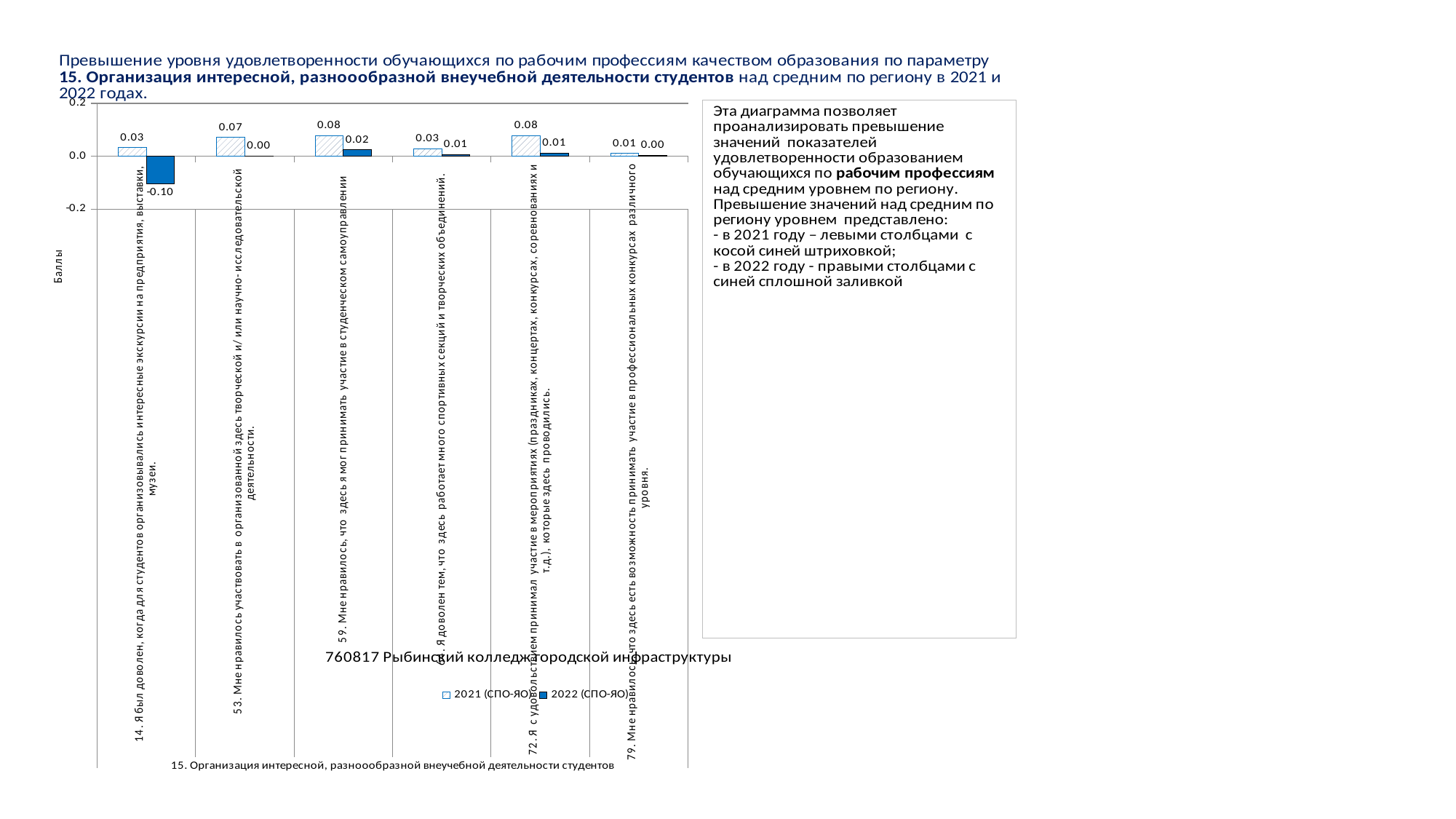
What is the 2022 (СПО-ЯО) value for item 72 (participation in events such as holidays, concerts, competitions)? 0.01 How many categories are shown on the x axis of the chart? 6 Which category has the lowest 2022 (СПО-ЯО) value? 14. Я был доволен, когда для студентов организовывались интересные экскурсии на предприятия, выставки, музеи. What is the 2021 (СПО-ЯО) value for item 59 (participation in student self-government)? 0.08 What type of chart is shown on the slide? Bar chart How many series does the legend list? 2 For item 59 (student self-government), which is larger: the 2021 value or the 2022 value? 2021 What is the 2021 (СПО-ЯО) value for item 14 (excursions to enterprises, exhibitions, museums)? 0.03 What is the 2022 (СПО-ЯО) value for item 14 (excursions to enterprises, exhibitions, museums)? -0.10 What is the difference between the 2021 and 2022 values for item 53 (creative and/or research activity)? 0.07 What is the label of the vertical axis of the chart? Баллы Which category has the lowest 2021 (СПО-ЯО) value? 79. Мне нравилось, что здесь есть возможность принимать участие в профессиональных конкурсах различного уровня.